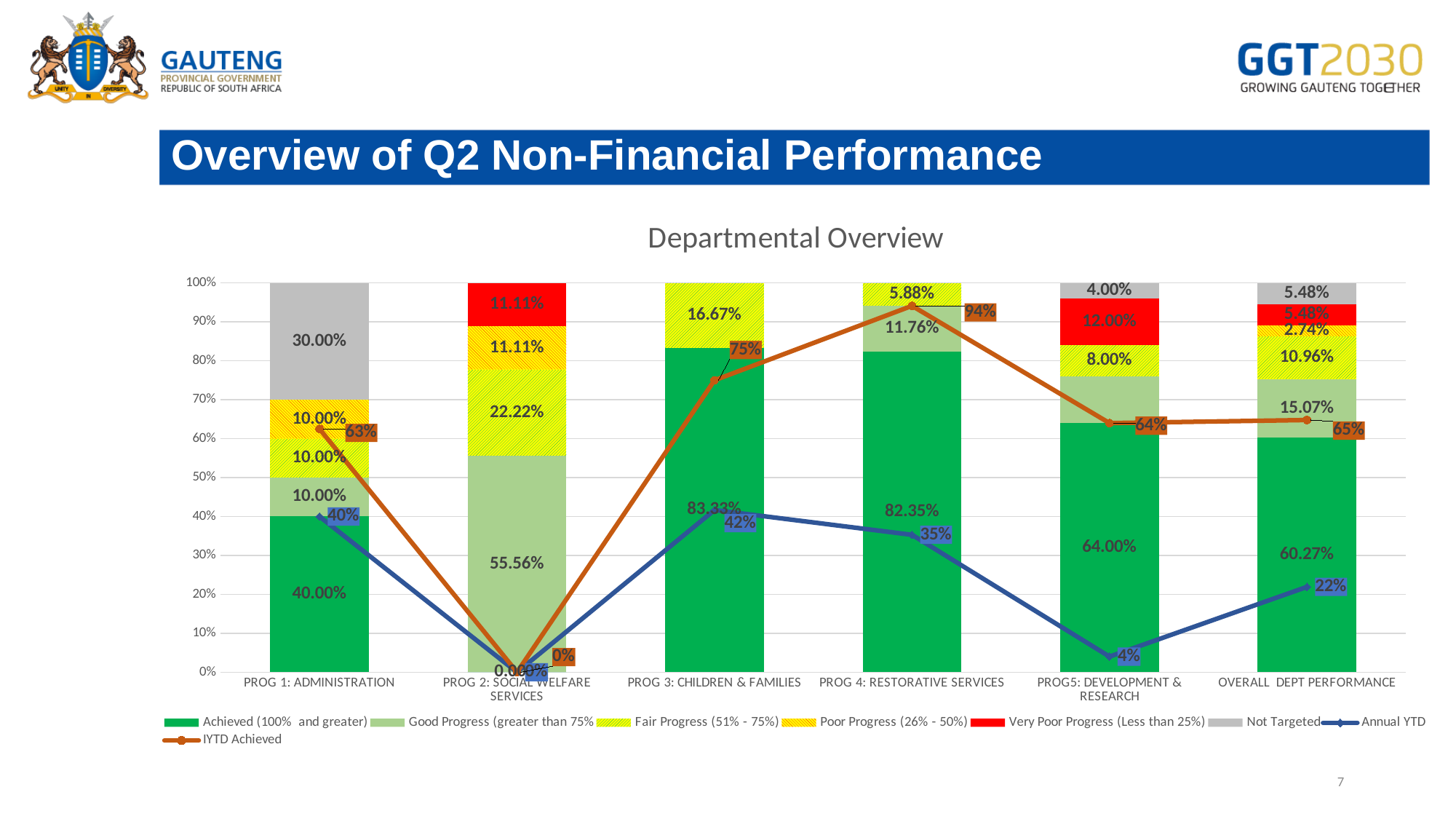
What type of chart is used to show the progress categories for each programme? Stacked bar chart How many series does the legend list? 8 What is the title of the chart? Departmental Overview What is the Achieved (100% and greater) value for PROG 3: CHILDREN & FAMILIES? 83.33% What is the IYTD Achieved value for PROG 4: RESTORATIVE SERVICES? 94% Which programme has the lowest Annual YTD value? PROG 2: SOCIAL WELFARE SERVICES What is the Annual YTD value for OVERALL DEPT PERFORMANCE? 22% What is the Not Targeted value for PROG 1: ADMINISTRATION? 30.00% Which is larger: the Good Progress value for PROG 2: SOCIAL WELFARE SERVICES or for PROG 4: RESTORATIVE SERVICES? PROG 2: SOCIAL WELFARE SERVICES What is the difference between the Achieved values for PROG5: DEVELOPMENT & RESEARCH and OVERALL DEPT PERFORMANCE? 3.73% Which programme has the highest IYTD Achieved value? PROG 4: RESTORATIVE SERVICES How many programme categories are shown on the x axis? 6